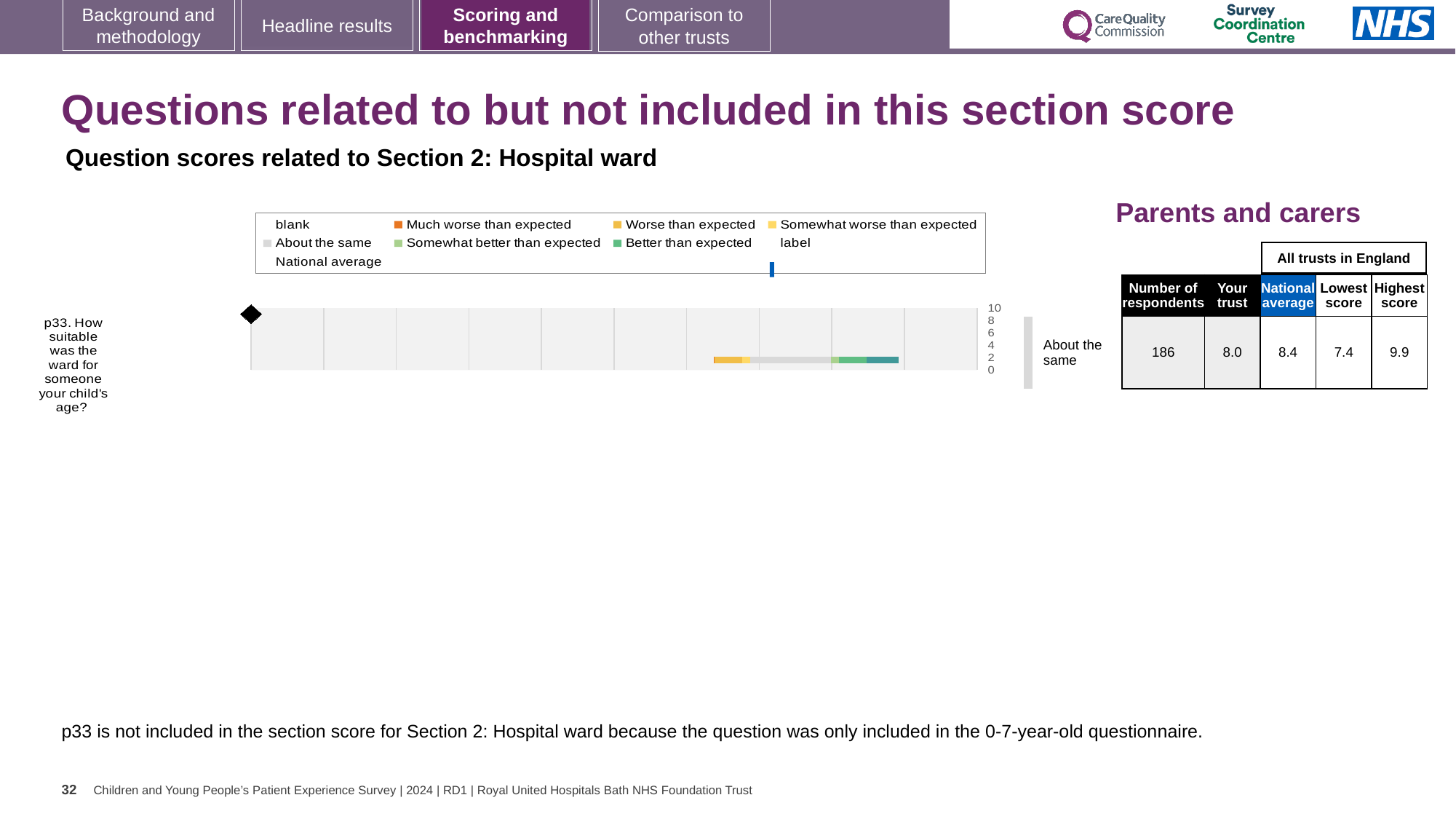
What is the difference between the highest score and the lowest score for p33? 2.5 How many respondents answered p33? 186 What benchmark category is shown next to the bar for p33? About the same Which is larger for p33, the 'Your trust' score or the national average? National average How many questions are plotted in the chart? 1 What is the highest score across all trusts in England for p33? 9.9 What is the lowest score across all trusts in England for p33? 7.4 What is the maximum value shown on the chart's score axis? 10 What kind of chart is used to show the p33 question score? bar chart Which question is plotted in the chart? p33. How suitable was the ward for someone your child's age? What is the 'Your trust' score for p33 in the table beside the chart? 8.0 What is the national average score for p33 in the table beside the chart? 8.4